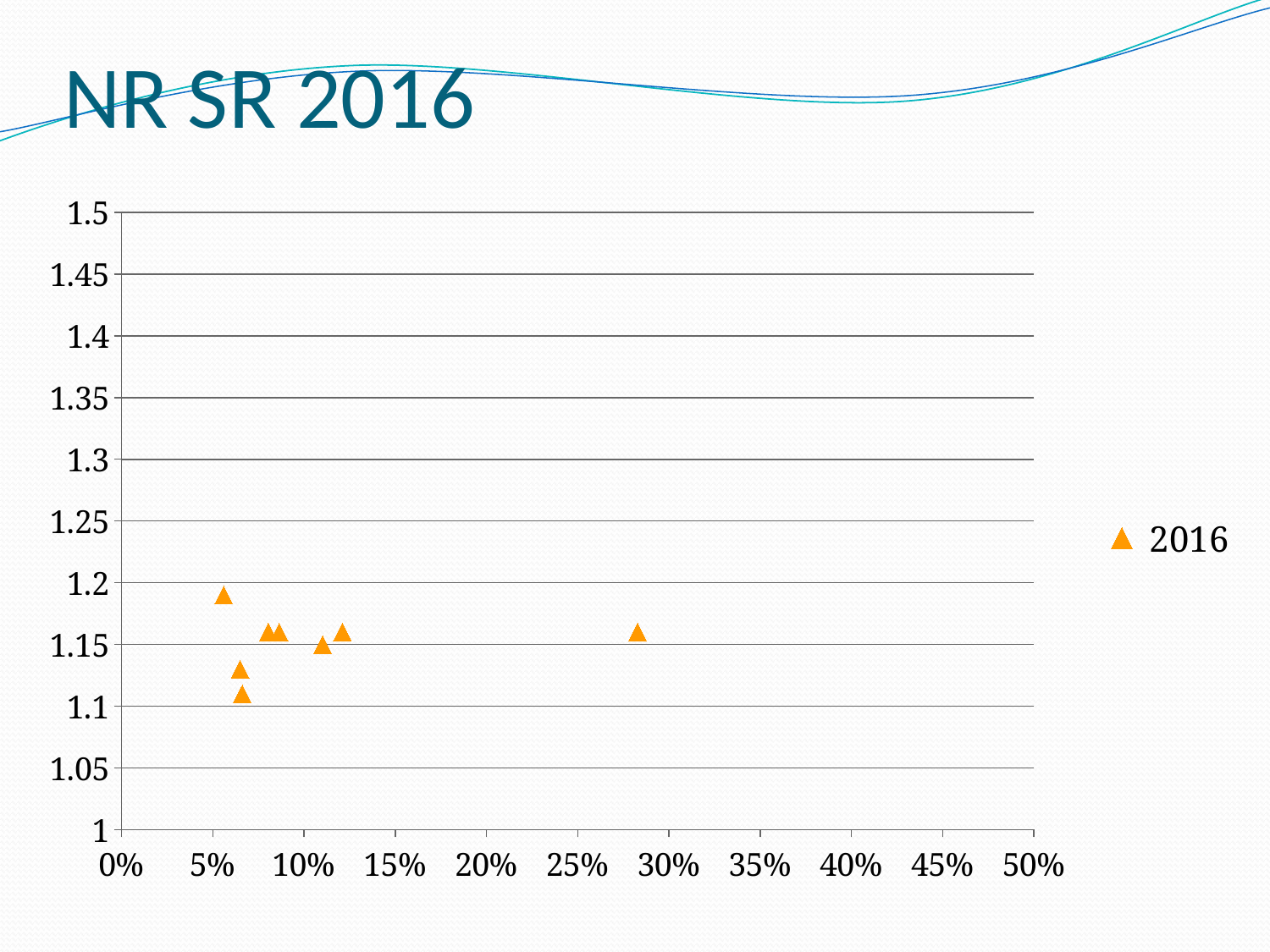
How many data points are plotted in the chart? 8 How many data points have an x value between 5% and 15%? 7 Are all the plotted y values greater or less than 1.25? less How many series does the legend list? 1 Are all the plotted y values greater or less than 1.05? greater How many data points have an x value greater than 20%? 1 What is the name of the series shown in the legend? 2016 Is the y value of the rightmost data point greater or less than 1.2? less What is the title of the slide containing the chart? NR SR 2016 What kind of chart is shown on the slide? scatter chart